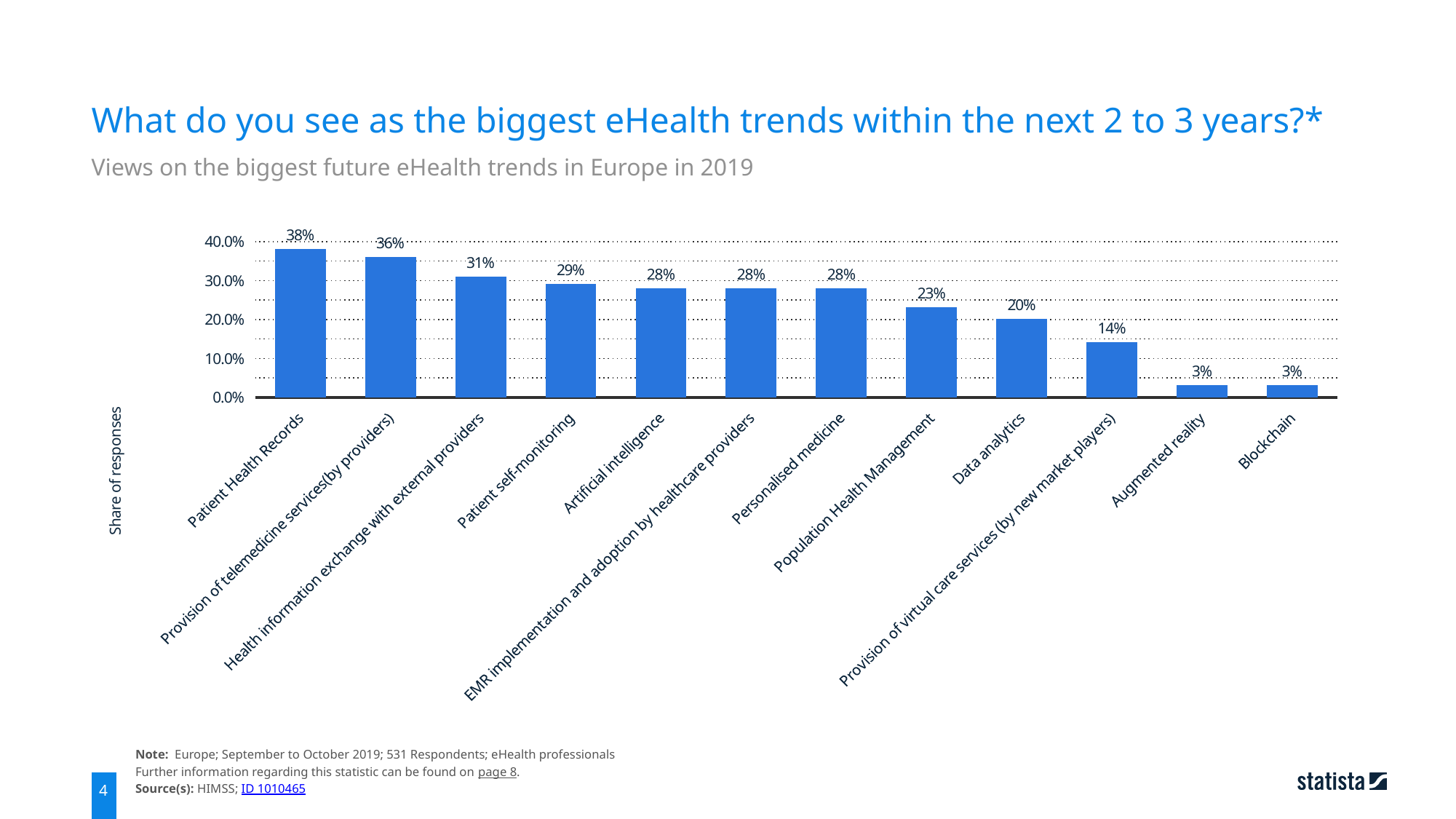
What is the difference between the shares for Patient Health Records and Provision of telemedicine services (by providers)? 2% What is the difference between the shares for Population Health Management and Augmented reality? 20% What share of responses is shown for Provision of virtual care services (by new market players)? 14% How many categories are shown in the chart? 12 What share of responses is shown for Patient Health Records? 38% Which has a larger share of responses, Health information exchange with external providers or Personalised medicine? Health information exchange with external providers What share of responses is shown for Data analytics? 20% Do the values rise or fall from left to right along the x axis? Fall What kind of chart is shown on the slide? Bar chart Is the value for Patient self-monitoring greater or less than 20.0%? greater Which category has the highest share of responses? Patient Health Records What is the label of the vertical axis? Share of responses